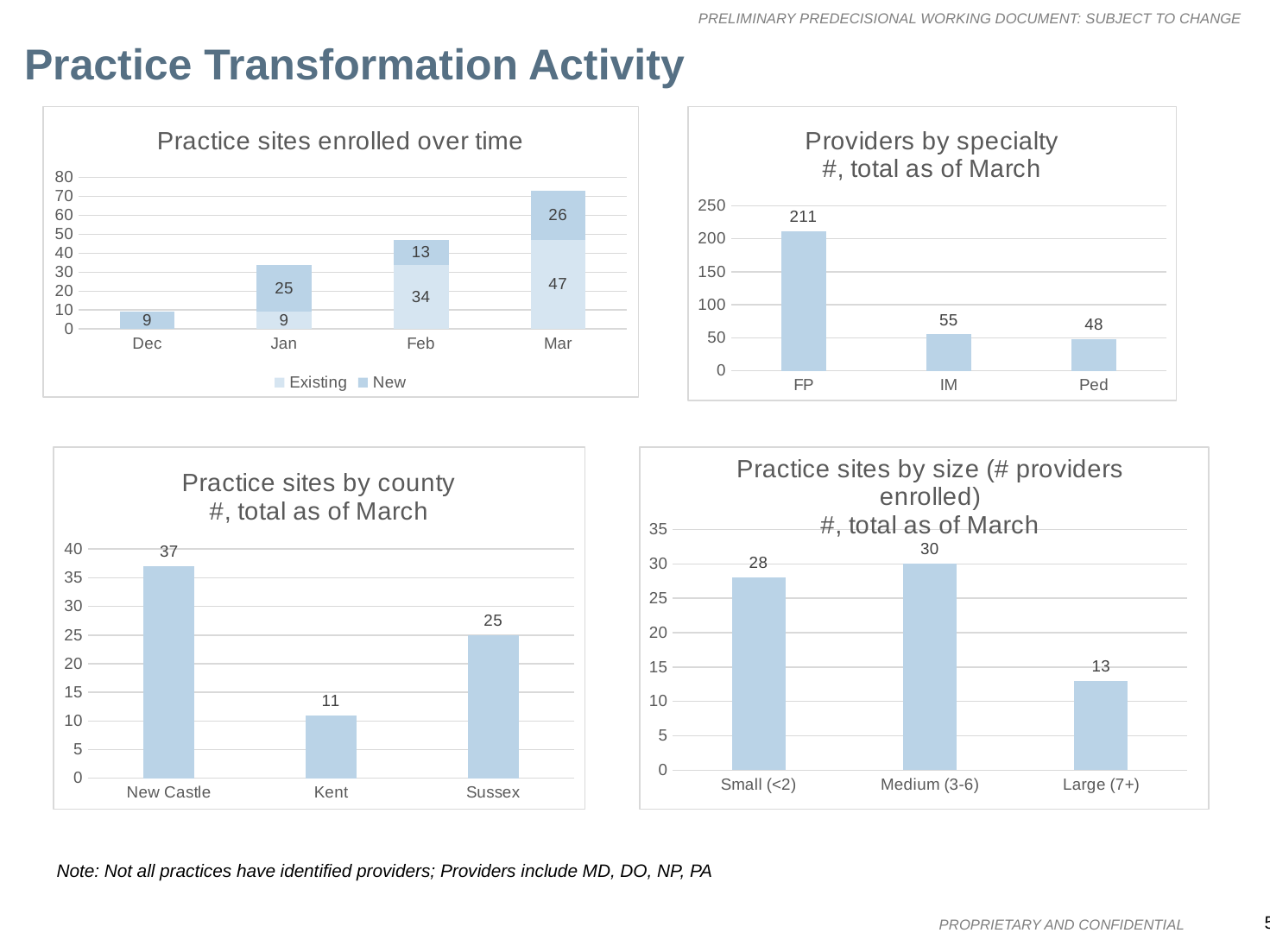
In the 'Practice sites by county' chart, what is the difference between New Castle and Kent? 26 What kind of chart is the 'Practice sites by size' chart? bar chart In the 'Providers by specialty' chart, which specialty has the lowest value? Ped In the 'Providers by specialty' chart, what is the difference between IM and Ped? 7 In the 'Practice sites enrolled over time' chart, do the total bar heights rise or fall from Dec to Mar? rise In the 'Providers by specialty' chart, what is the value for FP? 211 In the 'Practice sites by county' chart, which county has the highest value? New Castle In the 'Practice sites enrolled over time' chart, what is the value for New in Jan? 25 In the 'Practice sites enrolled over time' chart, how many series does the legend list? 2 In the 'Practice sites enrolled over time' chart, what is the total of the stacked bar for Feb? 47 In the 'Practice sites by size' chart, which is larger, Small (<2) or Medium (3-6)? Medium (3-6) In the 'Practice sites enrolled over time' chart, what is the value for Existing in Mar? 47